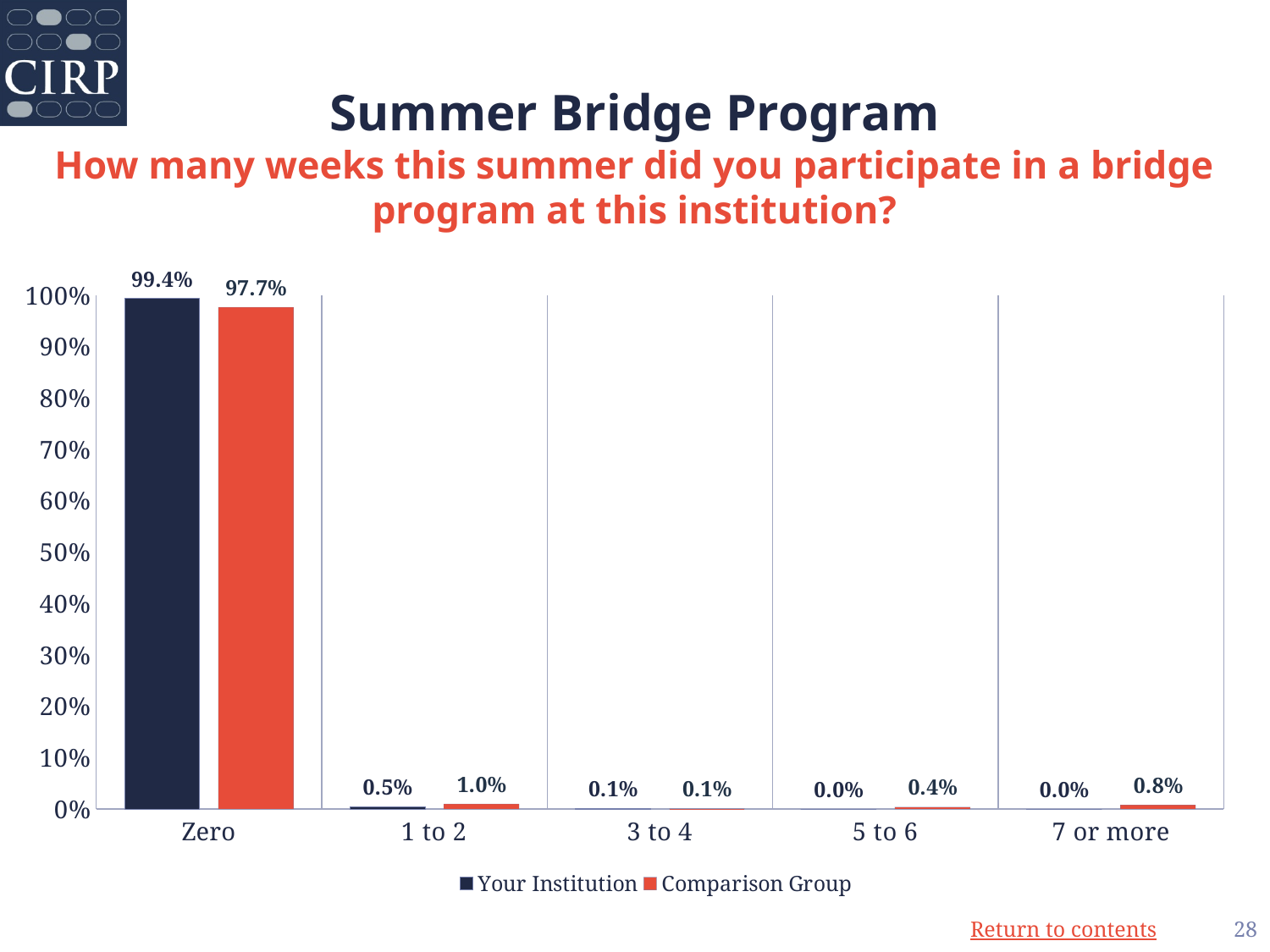
How many categories are shown on the x axis? 5 What kind of chart is shown on the slide? Bar chart What is the value for Your Institution in the 5 to 6 category? 0.0% What is the value for Your Institution in the Zero category? 99.4% How many series does the legend list? 2 Which category has the highest value for Comparison Group? Zero Which is larger in the 7 or more category, Your Institution or Comparison Group? Comparison Group What is the difference between Your Institution and Comparison Group in the Zero category? 1.7% Which is larger in the Zero category, Your Institution or Comparison Group? Your Institution What is the value for Comparison Group in the 1 to 2 category? 1.0% What is the value for Comparison Group in the 7 or more category? 0.8% What is the difference between Comparison Group and Your Institution in the 1 to 2 category? 0.5%